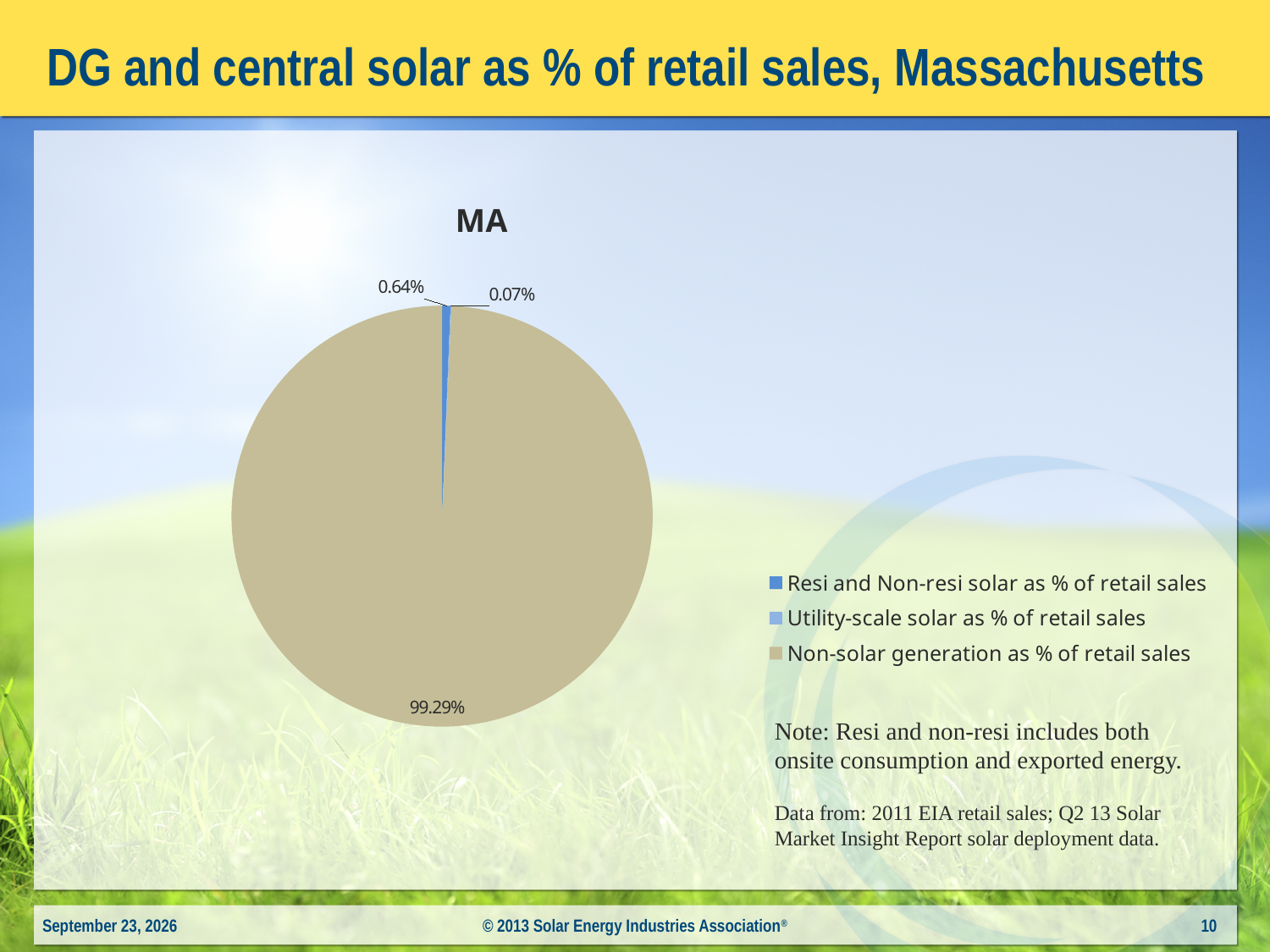
What colour is the Non-solar generation slice? tan What kind of chart is shown on the slide? pie chart Which slice of the pie is the smallest? Utility-scale solar as % of retail sales Which is larger, Resi and Non-resi solar or Utility-scale solar as % of retail sales? Resi and Non-resi solar as % of retail sales How many slices does the pie chart have? 3 How many entries does the legend list? 3 What is the difference between the Resi and Non-resi solar share and the Utility-scale solar share? 0.57% What share of retail sales is Resi and Non-resi solar? 0.64% What is the title of the chart? MA What share of retail sales is Utility-scale solar? 0.07% What share of retail sales is Non-solar generation? 99.29% Which slice of the pie is the largest? Non-solar generation as % of retail sales